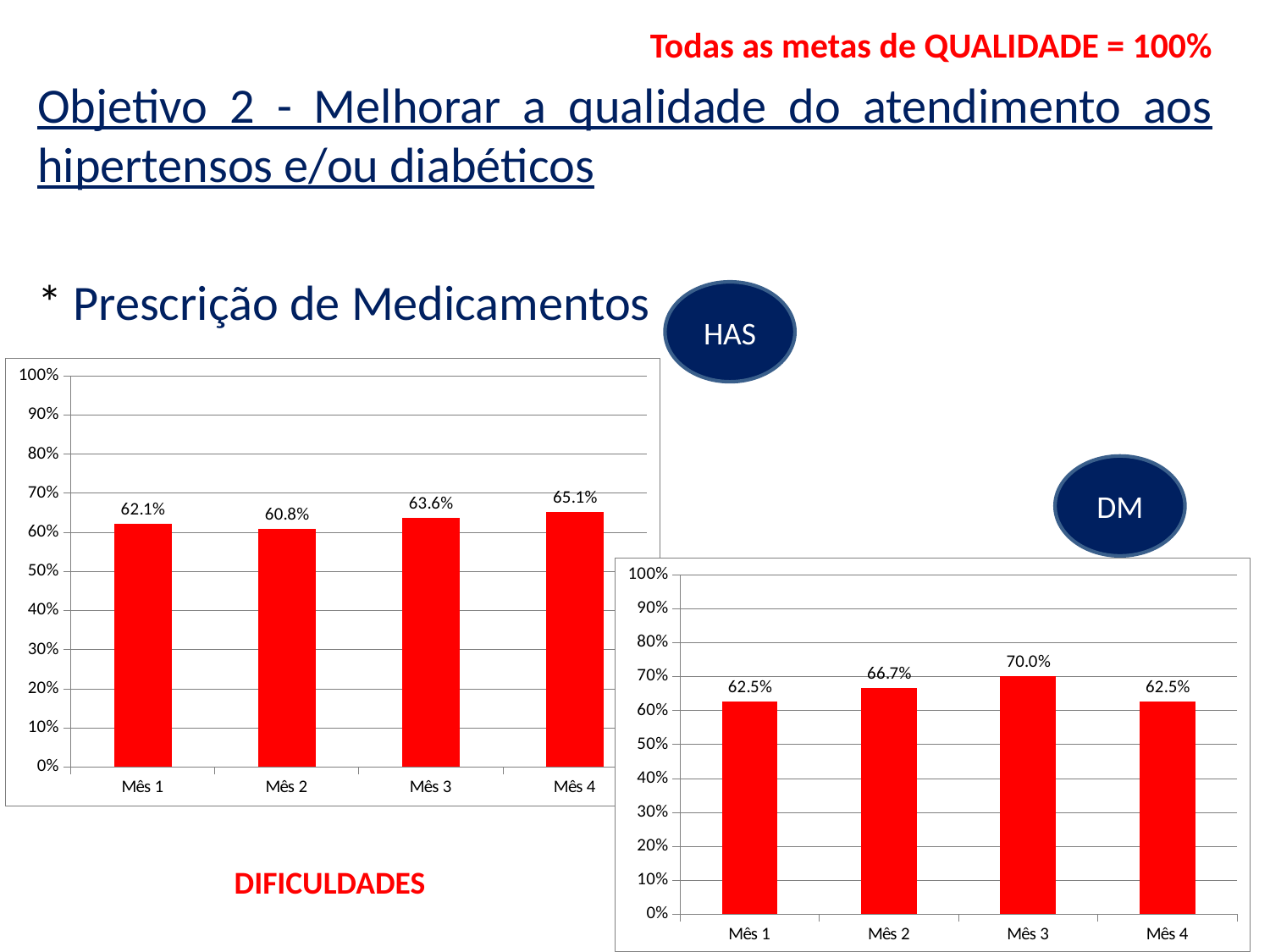
What kind of chart is the HAS chart (left)? bar chart In the HAS chart (left), what is the value for Mês 1? 62.1% In the DM chart (right), what is the value for Mês 3? 70.0% In the HAS chart (left), which month has the lowest value? Mês 2 In the DM chart (right), which month has the highest value? Mês 3 In the HAS chart (left), what is the difference between Mês 4 and Mês 2? 4.3% In the HAS chart (left), is the value for Mês 3 greater or less than 70%? less In the HAS chart (left), which month has the highest value? Mês 4 In the DM chart (right), which is larger, Mês 2 or Mês 4? Mês 2 How many months are shown in the DM chart (right)? 4 In the DM chart (right), what is the difference between Mês 3 and Mês 1? 7.5% What colour are the bars in the DM chart (right)? red